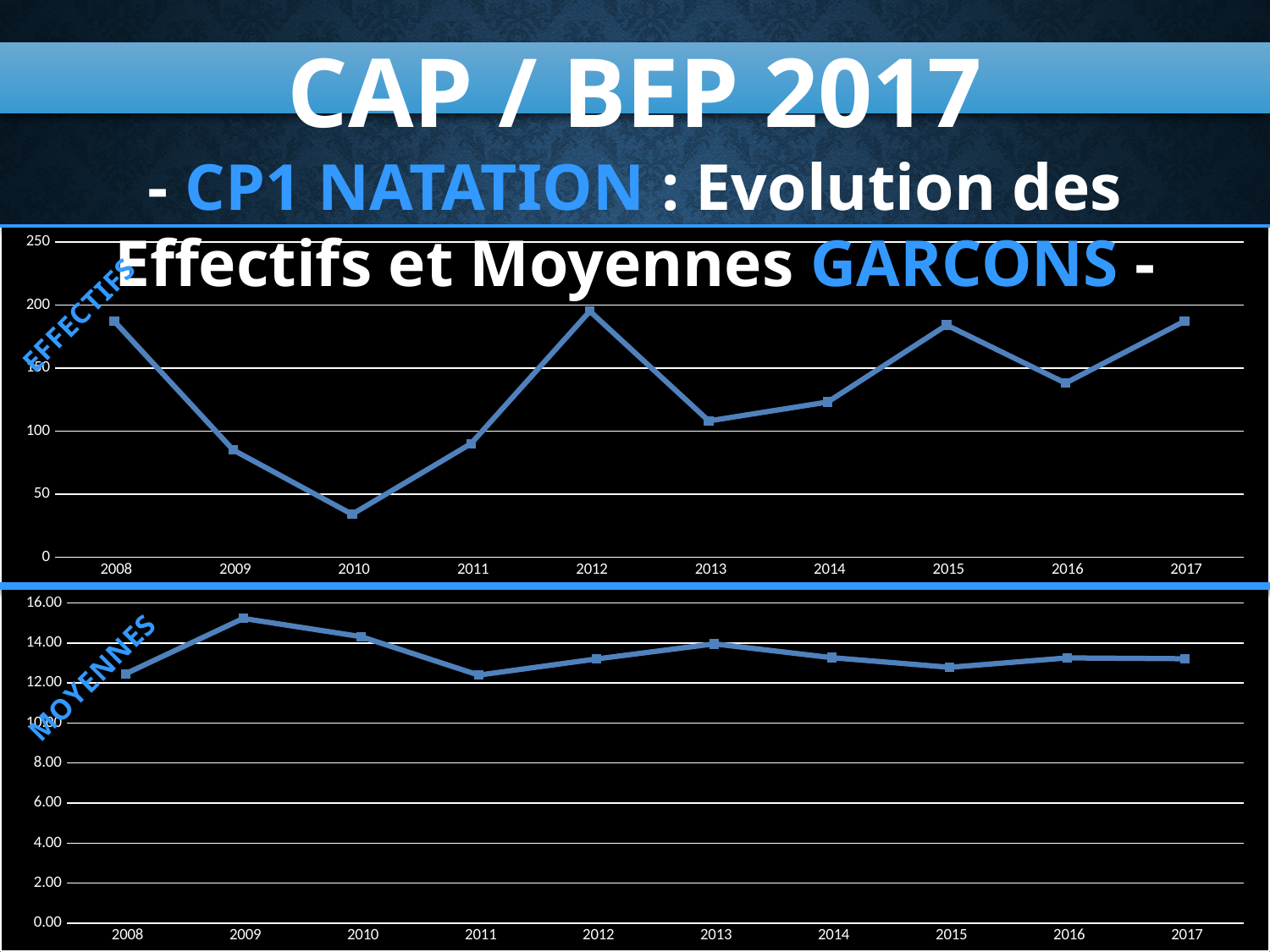
In the top chart (EFFECTIFS), which year has the lowest value? 2010 How many years are plotted on the x axis of the top chart (EFFECTIFS)? 10 In the top chart (EFFECTIFS), is the value for 2009 greater or less than 100? less In the bottom chart (MOYENNES), is the value for 2011 greater or less than 14.00? less In the top chart (EFFECTIFS), do the values rise or fall from 2010 to 2012? rise In the top chart (EFFECTIFS), is the value for 2010 greater or less than 50? less In the top chart (EFFECTIFS), which is larger, the value for 2015 or the value for 2016? 2015 What kind of chart is the top chart labelled EFFECTIFS? line chart In the bottom chart (MOYENNES), which is larger, the value for 2009 or the value for 2010? 2009 In the top chart (EFFECTIFS), which year has the highest value? 2012 In the bottom chart (MOYENNES), which year has the highest value? 2009